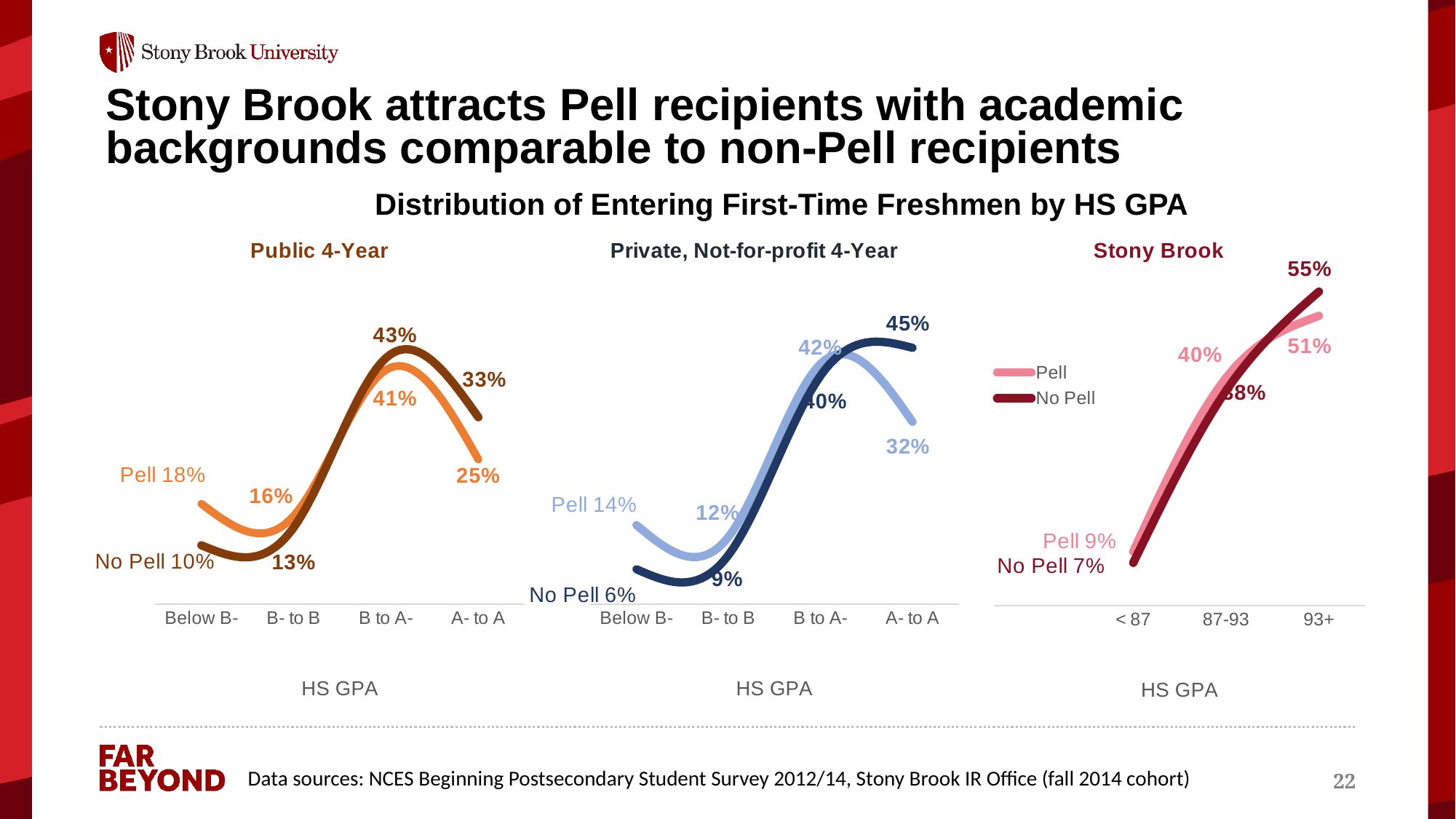
In the Public 4-Year chart, what is the Pell value for the B to A- GPA category? 41% In the Public 4-Year chart, what is the No Pell value for the A- to A GPA category? 33% In the Public 4-Year chart, which GPA category has the highest No Pell value? B to A- In the Stony Brook chart, what is the Pell value for the 87-93 GPA category? 40% In the Private, Not-for-profit 4-Year chart, which is larger for the A- to A category, the Pell value or the No Pell value? No Pell In the Public 4-Year chart, what is the difference between the Pell and No Pell values for the Below B- category? 8% In the Private, Not-for-profit 4-Year chart, which GPA category has the lowest Pell value? B- to B In the Private, Not-for-profit 4-Year chart, what is the Pell value for the A- to A category? 32% In the Private, Not-for-profit 4-Year chart, what is the No Pell value for the Below B- category? 6% What type of chart is used for the Stony Brook panel? Line chart How many GPA categories are shown on the x axis of the Stony Brook chart? 3 In the Stony Brook chart, what is the No Pell value for the 93+ GPA category? 55%